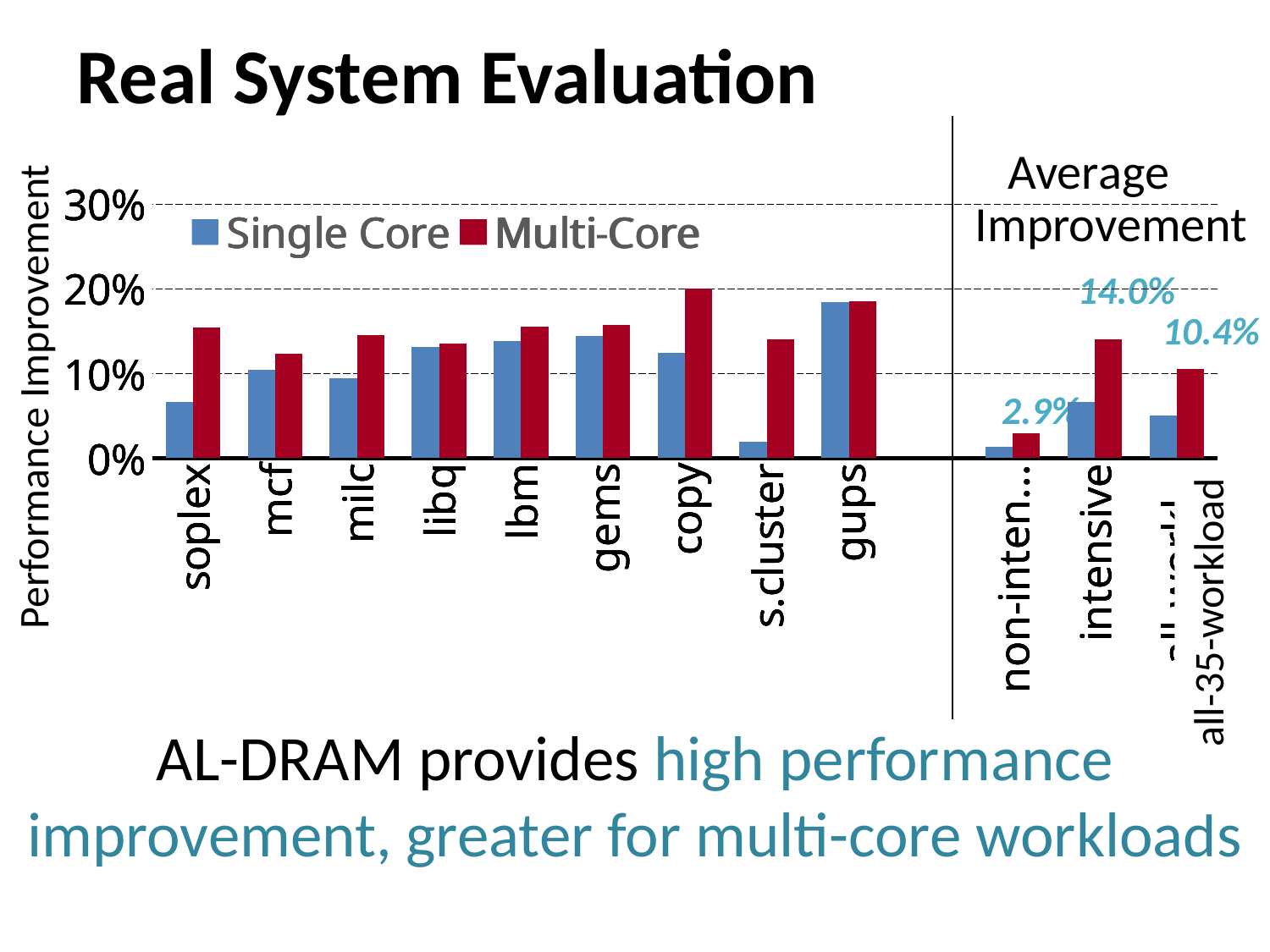
How many series does the legend list? 2 Among the nine individual workloads to the left of the vertical divider, which has the lowest Single Core value? s.cluster What is the Multi-Core average improvement for the non-intensive workloads? 2.9% What are the two series named in the legend? Single Core and Multi-Core For soplex, which is larger: the Single Core value or the Multi-Core value? Multi-Core What is the Multi-Core average improvement for the intensive workloads? 14.0% Is the Single Core value for s.cluster greater or less than 10%? less What is the difference between the Multi-Core average improvement for intensive workloads and for non-intensive workloads? 11.1% What is the Multi-Core average improvement for all-35-workload? 10.4% Among the nine individual workloads to the left of the vertical divider, which has the highest Single Core value? gups What kind of chart is shown on the slide? bar chart Is the Multi-Core value for soplex greater or less than 10%? greater